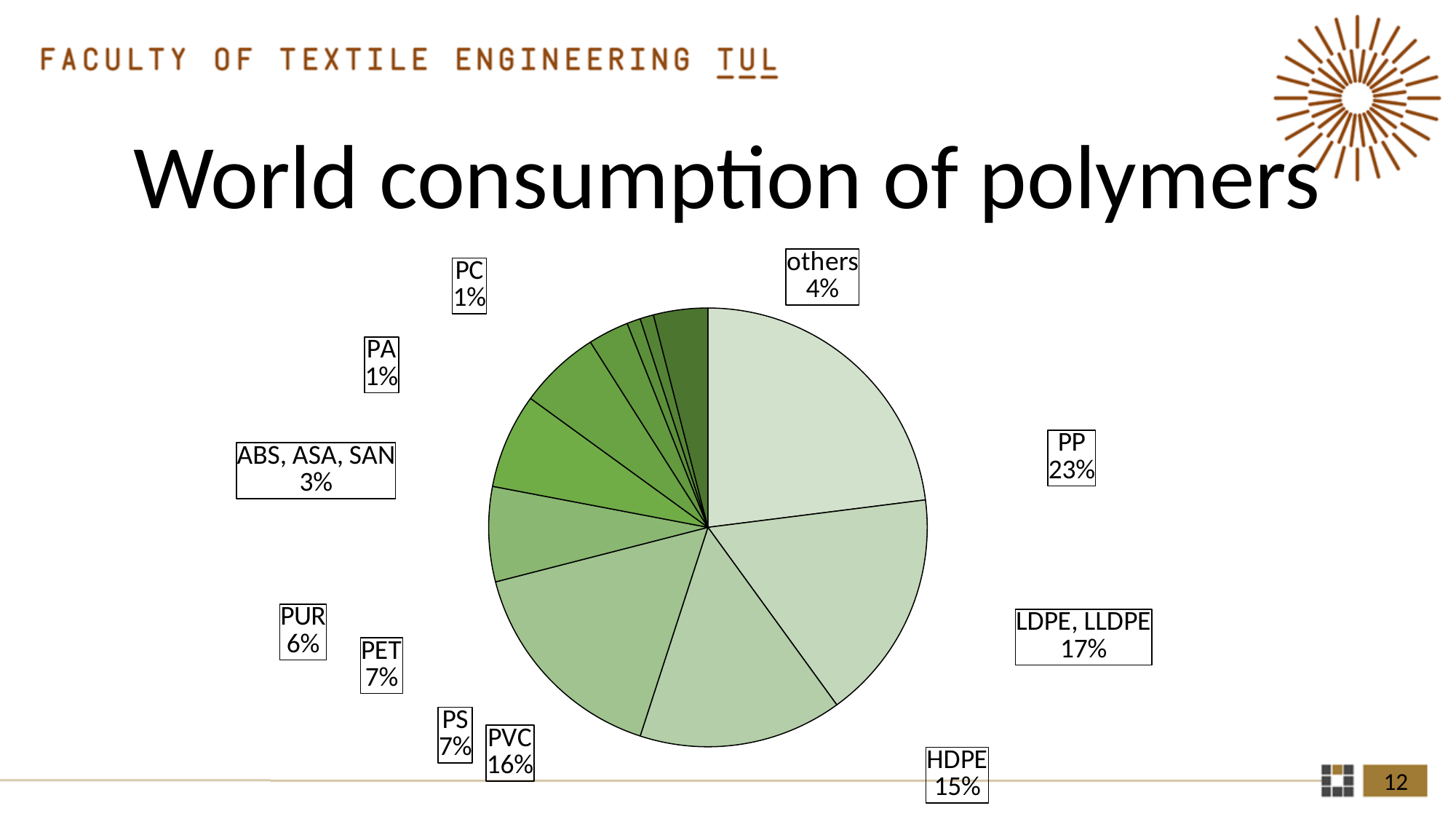
What percentage is shown for ABS, ASA, SAN? 3% What is the difference in percentage points between PP and HDPE? 8 What is the title of the slide containing the pie chart? World consumption of polymers What type of chart is shown on the slide? pie chart What is the value shown for LDPE, LLDPE? 17% How many categories are shown in the pie chart? 11 What share does HDPE have in the pie chart? 15% What percentage of world polymer consumption is PVC? 16% Which polymer has the largest share of world consumption? PP What is the combined share of PS and PET? 14% What is the share of PP in the world consumption of polymers? 23% Which has a larger share, PVC or LDPE, LLDPE? LDPE, LLDPE